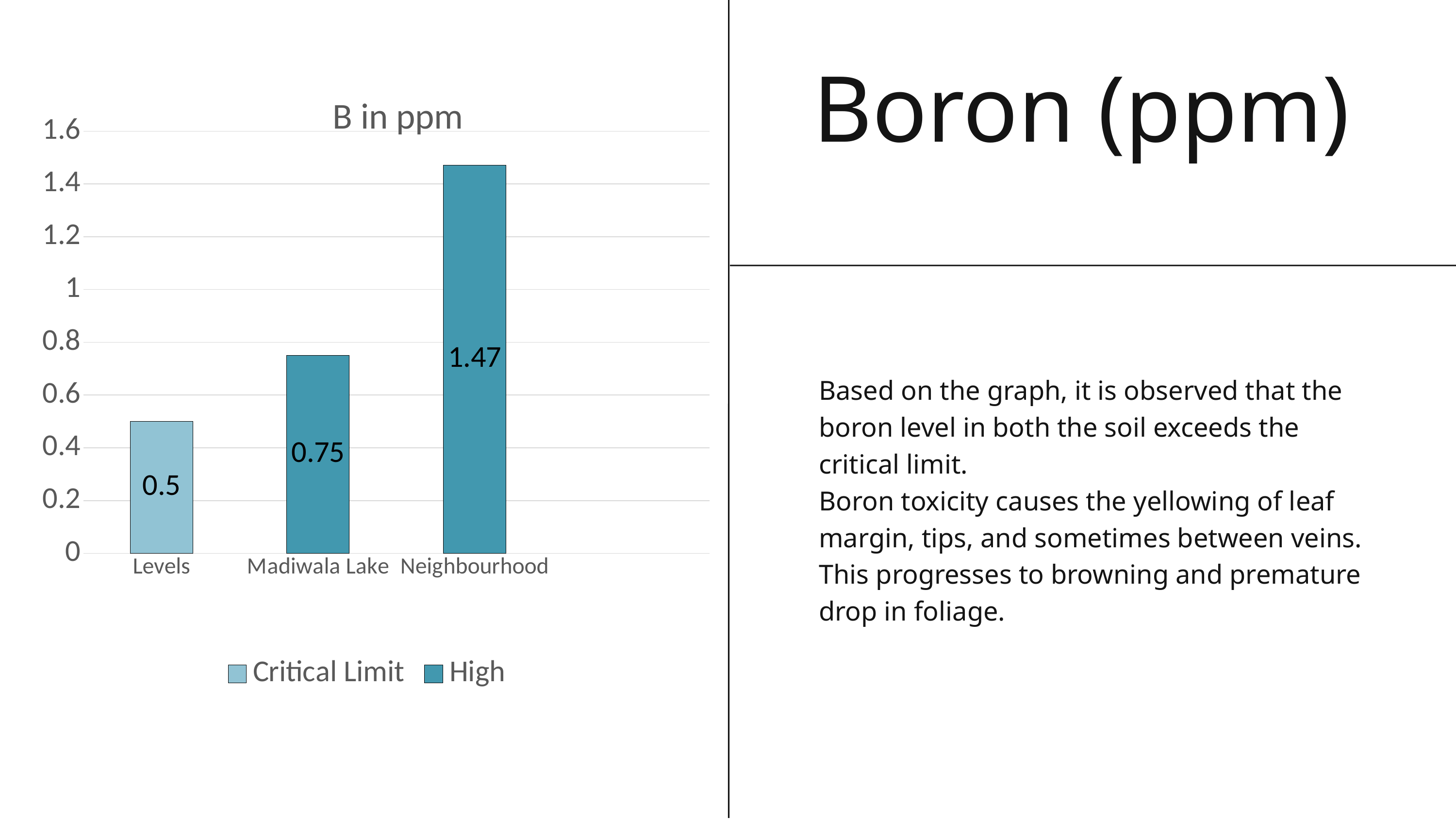
How many series does the legend list? 2 What is the difference between the values for Neighbourhood and Madiwala Lake? 0.72 Which category has the highest value? Neighbourhood Is the value for Neighbourhood greater or less than 1? greater Which is larger, the value for Madiwala Lake or the value for Levels? Madiwala Lake What is the value for Neighbourhood? 1.47 What is the value for Madiwala Lake? 0.75 How many categories are shown on the x axis? 3 What kind of chart is shown on the slide? bar chart What is the difference between the values for Madiwala Lake and Levels? 0.25 What is the value for Levels? 0.5 Which category has the lowest value? Levels